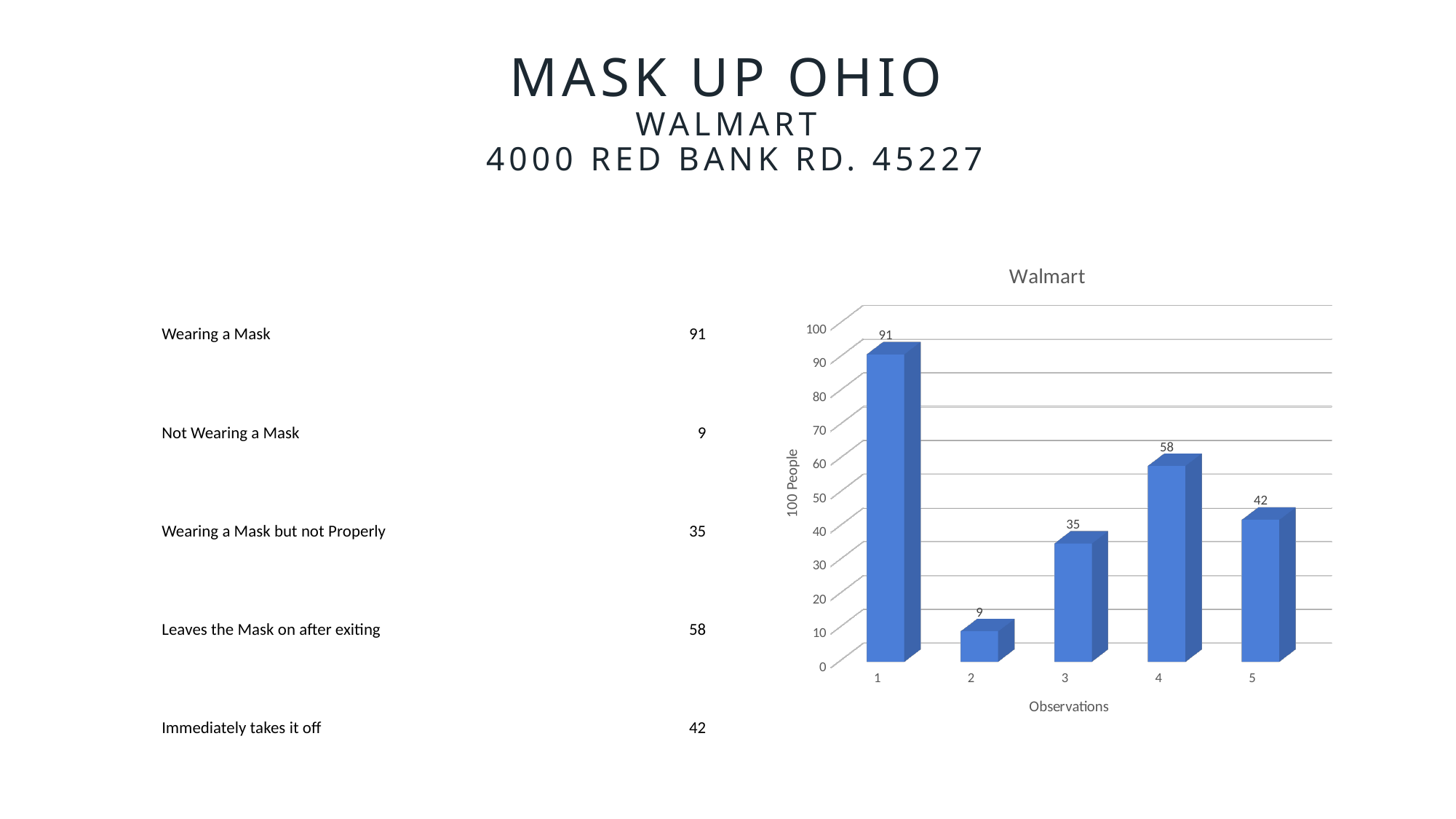
What kind of chart is shown on the slide? bar chart What is the difference between the values for observation 4 and observation 5? 16 Which observation has the highest value in the Walmart chart? 1 Is the value for observation 3 greater or less than 40? less What is the label of the vertical axis in the Walmart chart? 100 People Which observation has the lowest value in the Walmart chart? 2 Which is larger, the value for observation 3 or observation 5? observation 5 What is the value for observation 1 in the Walmart chart? 91 What is the value for observation 2 in the Walmart chart? 9 How many bars are plotted in the Walmart chart? 5 What is the difference between the values for observation 1 and observation 2? 82 What is the value for observation 4 in the Walmart chart? 58